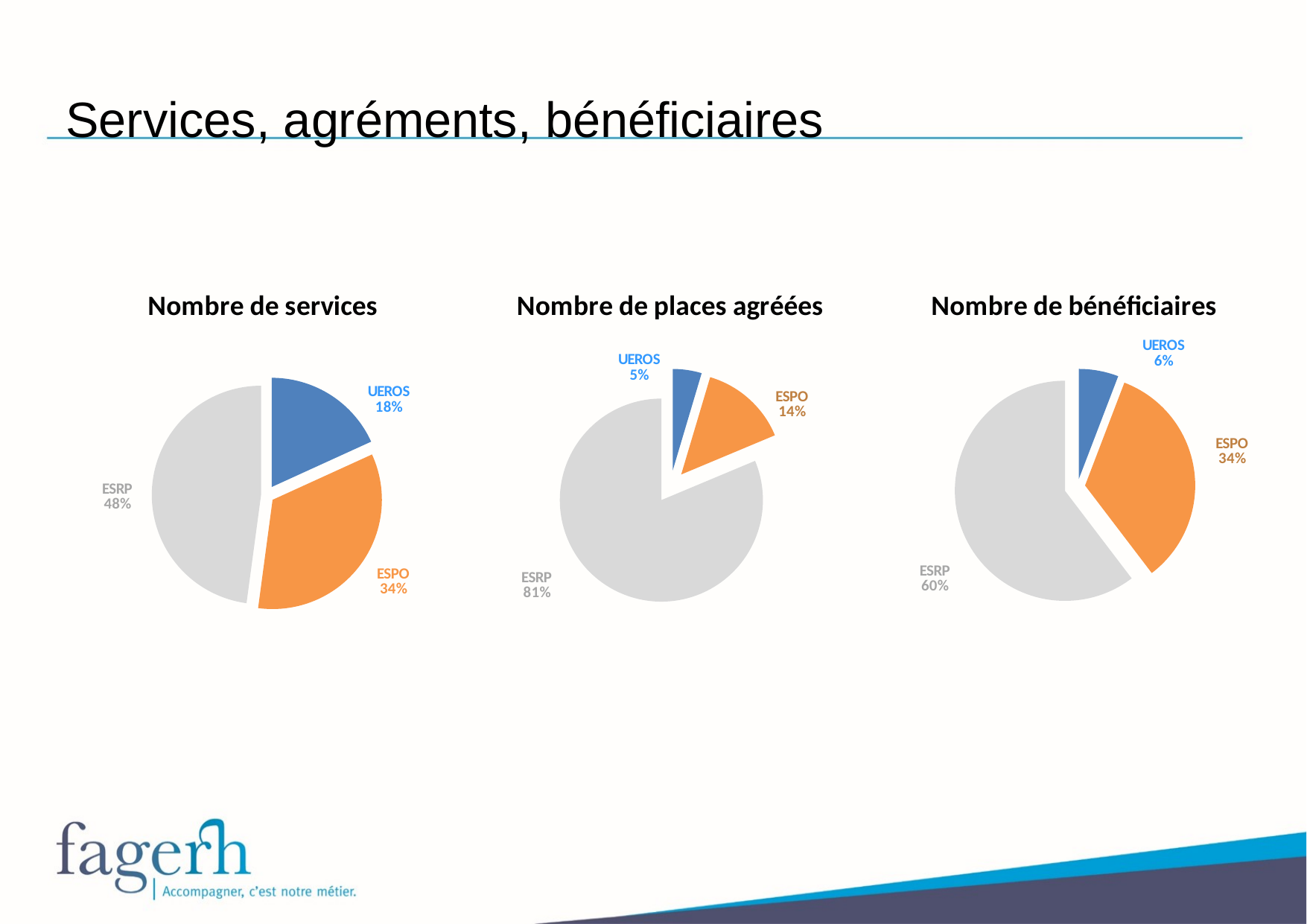
How many slices does the 'Nombre de services' chart have? 3 What colour is the ESPO slice in the 'Nombre de bénéficiaires' chart? Orange In the 'Nombre de places agréées' chart, which category has the smallest share? UEROS What kind of chart is 'Nombre de places agréées'? Pie chart In the 'Nombre de bénéficiaires' chart, which category has the largest share? ESRP In the 'Nombre de places agréées' chart, what share does ESRP have? 81% In the 'Nombre de bénéficiaires' chart, what is the value for UEROS? 6% In the 'Nombre de services' chart, what is the value for UEROS? 18% In the 'Nombre de places agréées' chart, what is the value for ESPO? 14% In the 'Nombre de bénéficiaires' chart, which is larger, ESPO or UEROS? ESPO In the 'Nombre de services' chart, what share does ESRP have? 48% In the 'Nombre de services' chart, what is the difference between the ESRP and ESPO shares? 14%